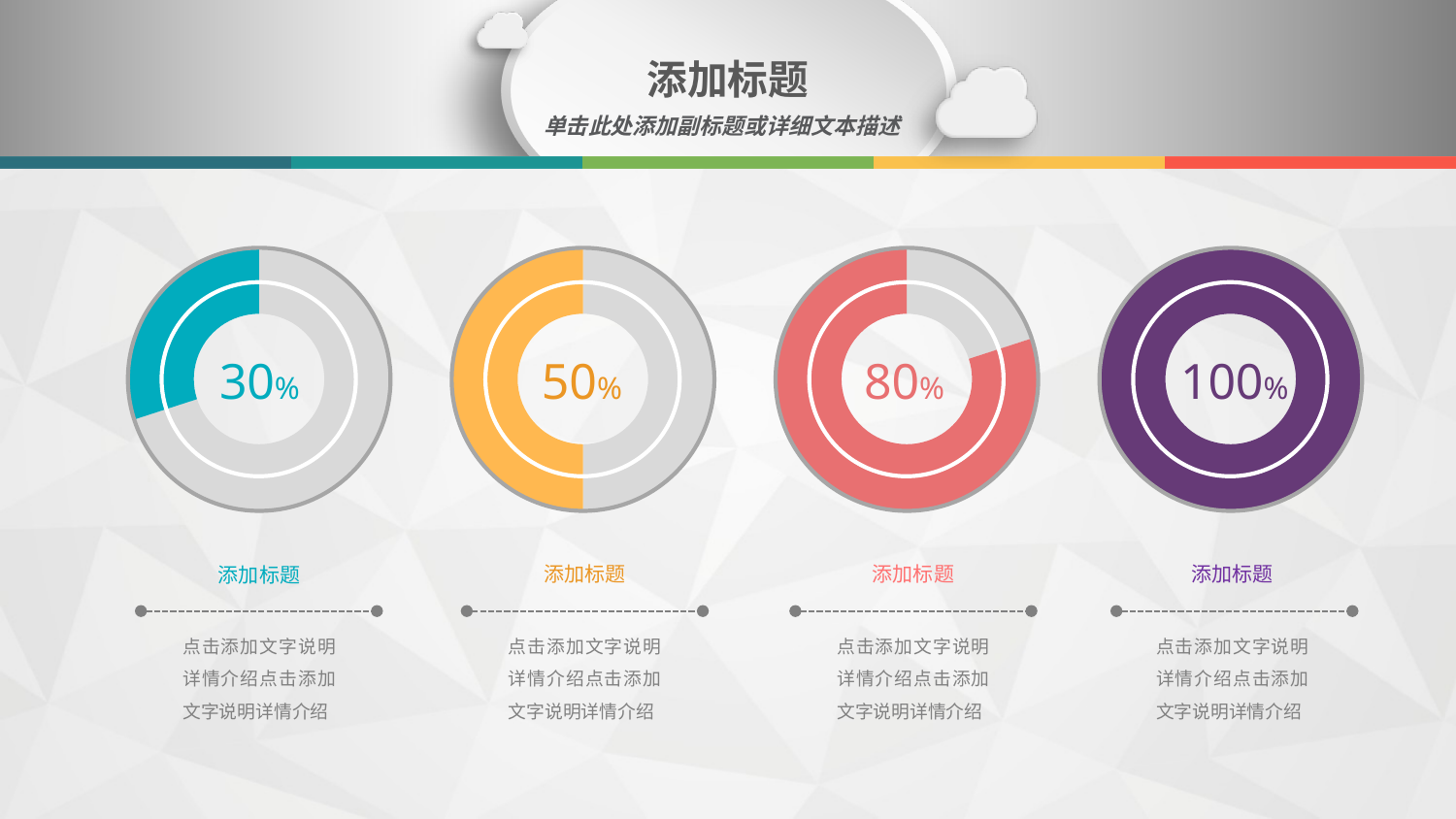
Which is larger, the value in the second donut chart or the value in the third donut chart? the third donut chart (80%) How many donut charts are on the slide? 4 Which donut chart shows the lowest value? the leftmost (30%) What kind of chart is used to display the percentages on the slide? donut chart What is the difference between the rightmost donut chart's value and the second donut chart's value? 50% Which donut chart shows the highest value? the rightmost (100%) What value is shown in the rightmost donut chart? 100% What value is shown in the leftmost donut chart? 30% What is the difference between the value in the third donut chart and the value in the leftmost donut chart? 50% What colour is the filled portion of the rightmost donut chart? purple What value is shown in the second donut chart from the left? 50% What value is shown in the third donut chart from the left? 80%